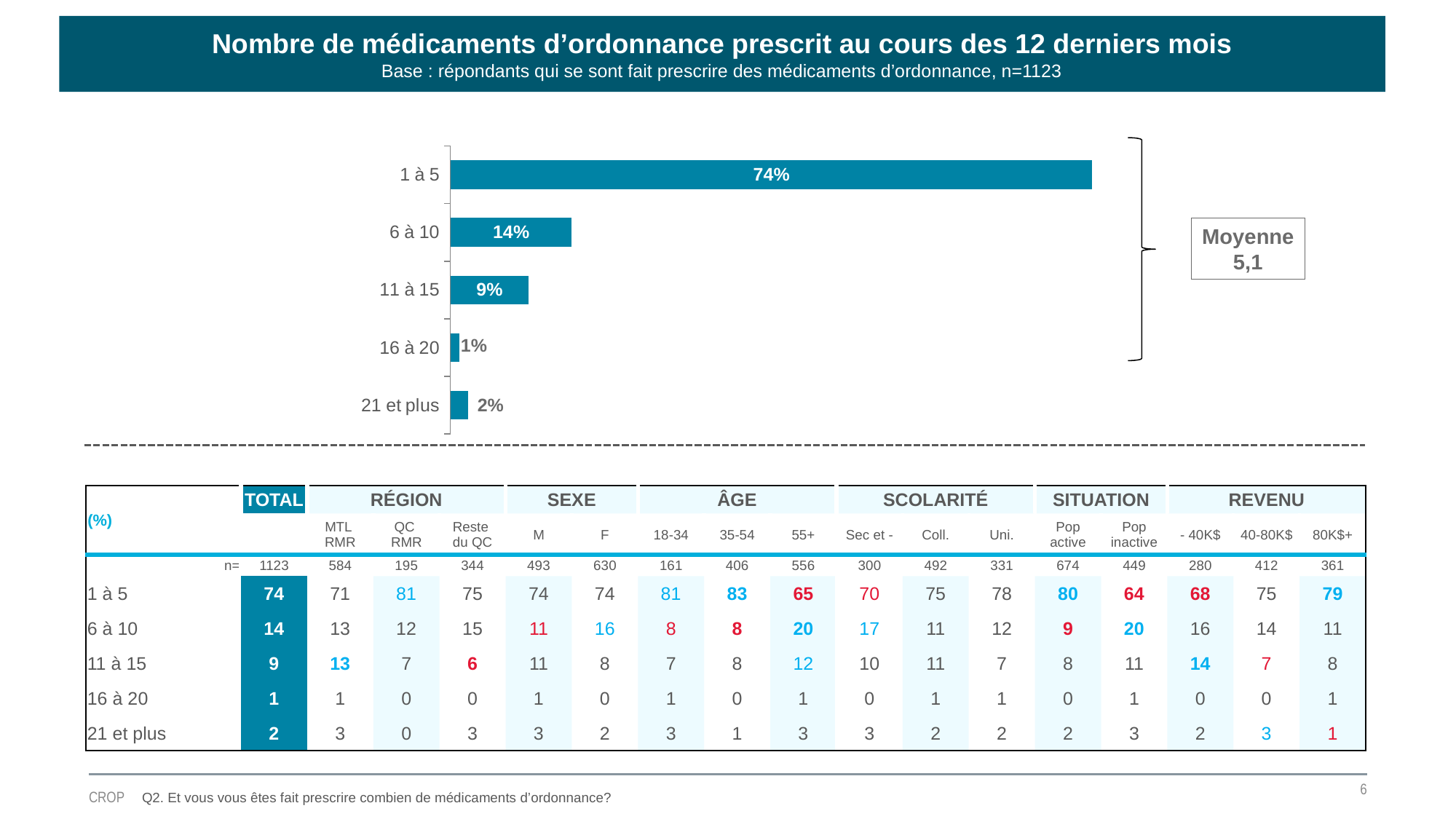
What is the base size (n) stated in the chart subtitle? n=1123 What is the value for the '21 et plus' category in the bar chart? 2% What is the difference between the values for '1 à 5' and '6 à 10' in the bar chart? 60% What is the value for the '1 à 5' category in the bar chart? 74% How many categories are shown in the bar chart? 5 Which category has the highest value in the bar chart? 1 à 5 Which is larger in the bar chart: the value for '11 à 15' or the value for '21 et plus'? 11 à 15 What is the 'Moyenne' (average) value shown next to the bar chart? 5,1 What is the value for the '6 à 10' category in the bar chart? 14% What kind of chart is shown on the slide? Bar chart Which category has the lowest value in the bar chart? 16 à 20 What is the value for the '11 à 15' category in the bar chart? 9%